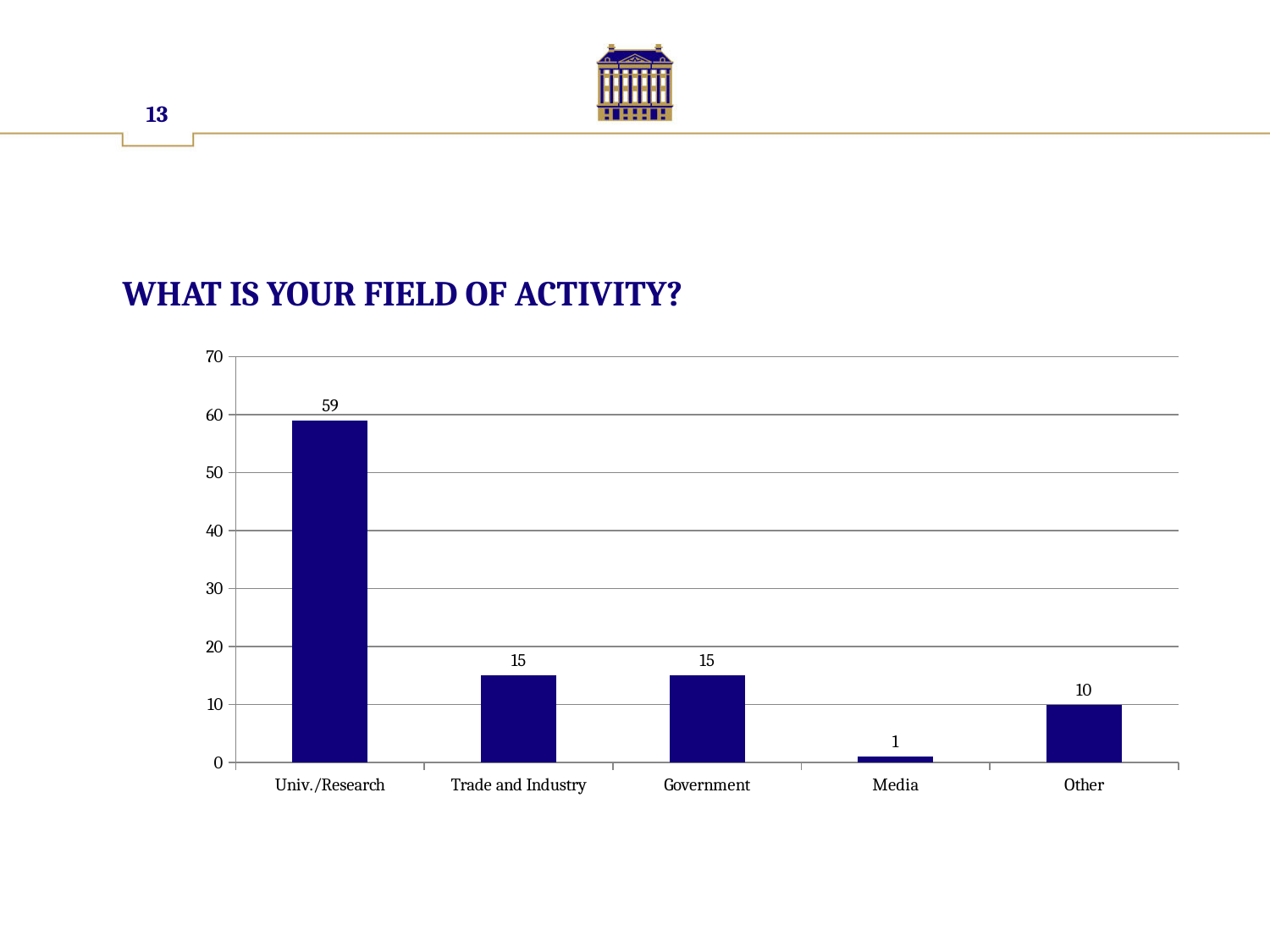
What is the value for Government? 15 What kind of chart is shown on the slide? bar chart Which category has the highest value? Univ./Research Which is larger, the value for Government or the value for Other? Government Which category has the lowest value? Media What is the difference between the values for Univ./Research and Trade and Industry? 44 What is the difference between the values for Other and Media? 9 What is the value for Media? 1 Is the value for Univ./Research greater or less than 50? greater How many categories are shown on the x axis? 5 What is the value for Other? 10 What is the value for Univ./Research? 59